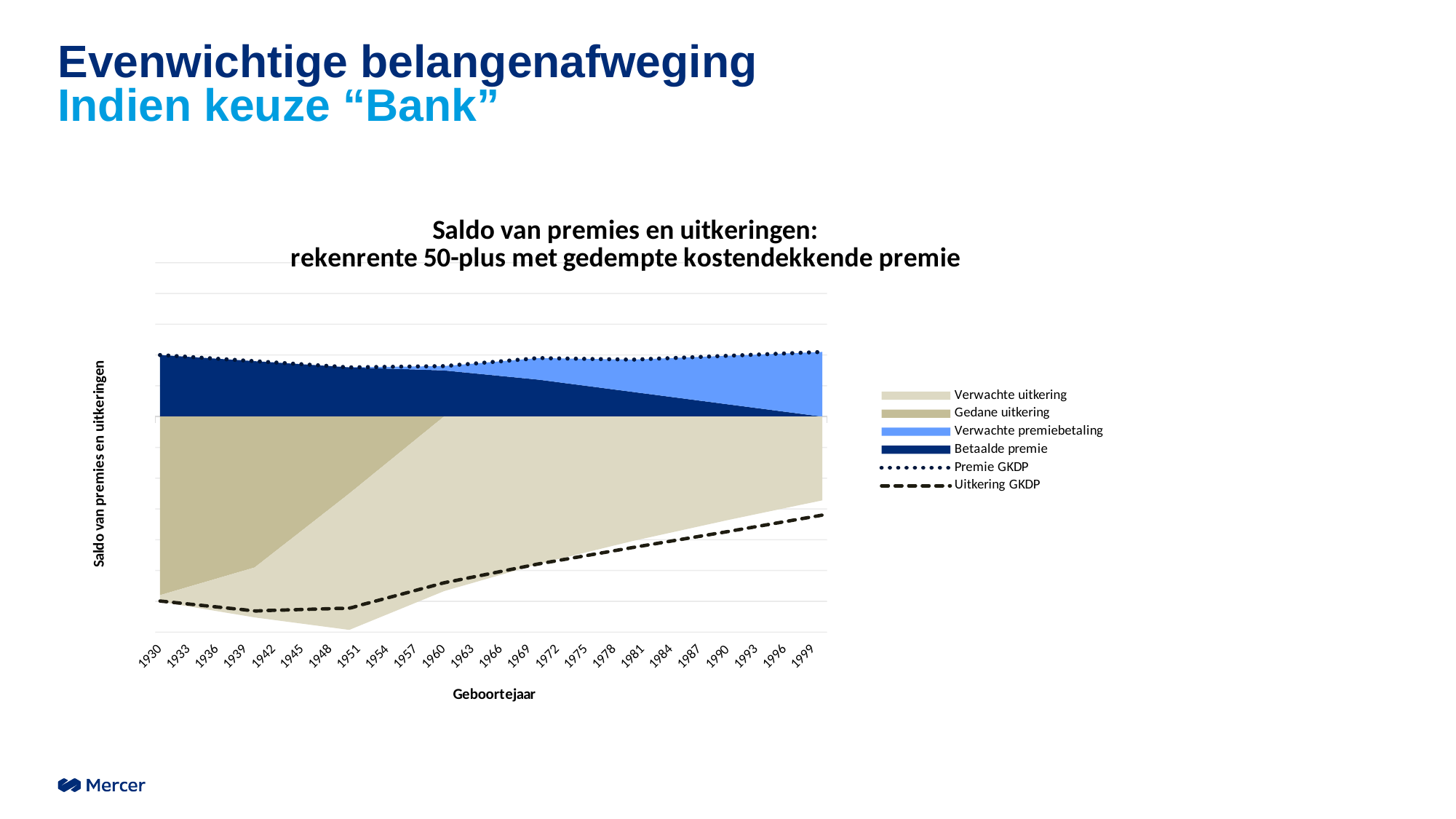
What kind of chart is shown on the slide? Area chart with line series What is the label of the x axis of the chart? Geboortejaar Does the Verwachte premiebetaling area get larger or smaller as the birth year increases from 1960 to 1999? Larger What is the first birth year labelled on the x axis of the chart? 1930 Which legend entry is drawn as a dotted line? Premie GKDP What is the title of the chart? Saldo van premies en uitkeringen: rekenrente 50-plus met gedempte kostendekkende premie How many series does the chart's legend list? 6 Does the Betaalde premie area get larger or smaller as the birth year increases from 1960 to 1999? Smaller Does the Uitkering GKDP line rise or fall between birth year 1951 and birth year 1999? Rise How many birth-year categories are labelled on the x axis of the chart? 24